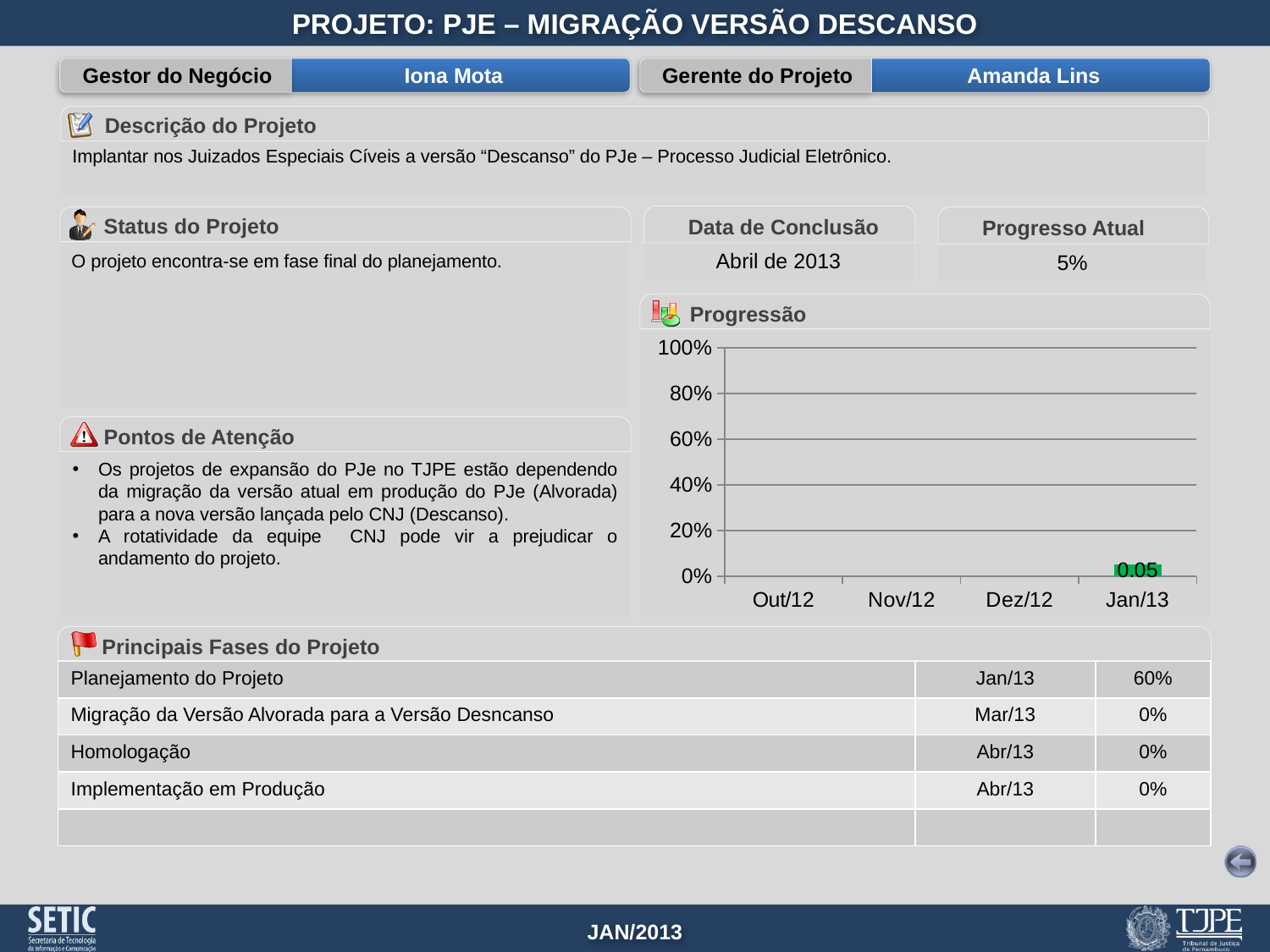
What kind of chart is shown under "Progressão"? bar chart What is the highest value shown on the y axis of the "Progressão" chart? 100% Which category appears last on the x axis of the "Progressão" chart? Jan/13 Is the value for Jan/13 in the "Progressão" chart greater or less than 20%? less Which category has the highest bar in the "Progressão" chart? Jan/13 What is the title of the chart on the slide? Progressão How many categories are shown on the x axis of the "Progressão" chart? 4 What value is labelled on the bar for Jan/13 in the "Progressão" chart? 0.05 Which category appears first on the x axis of the "Progressão" chart? Out/12